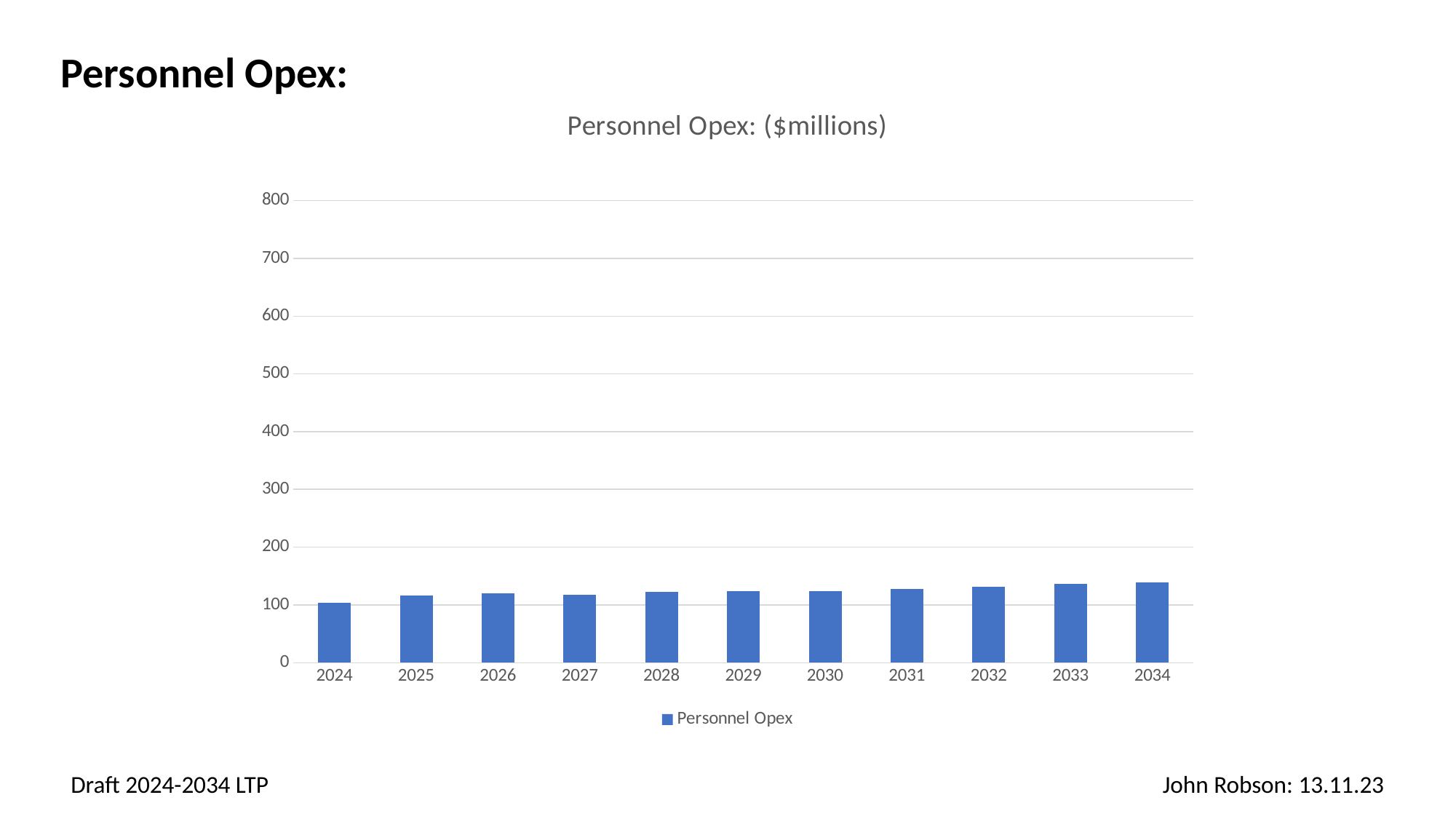
What is the name of the series shown in the legend? Personnel Opex Do the Personnel Opex values generally rise or fall from 2024 to 2034? Rise Which year has the lowest Personnel Opex? 2024 Is the value for 2034 greater or less than 200? less What is the title of the chart? Personnel Opex: ($millions) Which is larger, the value for 2024 or the value for 2034? 2034 Is the value for 2030 greater or less than 300? less How many years are shown on the x axis of the chart? 11 How many series does the legend list? 1 What kind of chart is shown on the slide? Bar chart Which year has the highest Personnel Opex? 2034 Is the value for 2025 greater or less than 100? greater